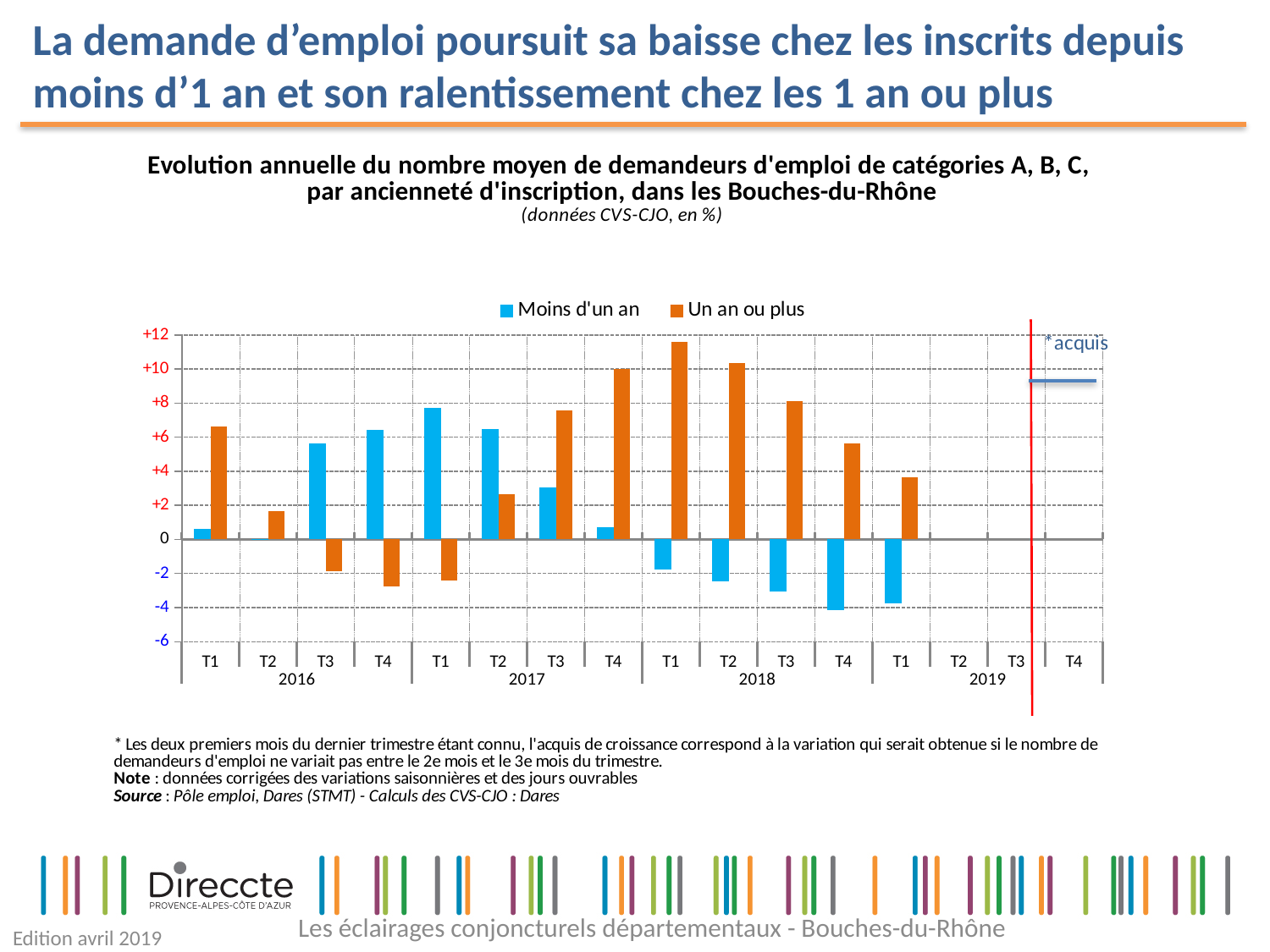
Is the value for 'Un an ou plus' in T3 2017 greater or less than +6? greater What kind of chart is shown on the slide? bar chart In which quarter does the 'Moins d'un an' series reach its highest value? T1 2017 Is the value for 'Moins d'un an' in T3 2018 greater or less than -2? less In which quarter does the 'Un an ou plus' series reach its highest value? T1 2018 How many quarters have bars plotted on the chart? 13 Is the value for 'Un an ou plus' in T1 2018 greater or less than +10? greater How many series does the legend list? 2 Does the 'Un an ou plus' series rise or fall from T1 2018 to T1 2019? fall In T1 2016, which series has the larger value, 'Moins d'un an' or 'Un an ou plus'? Un an ou plus What are the two series named in the legend? Moins d'un an; Un an ou plus